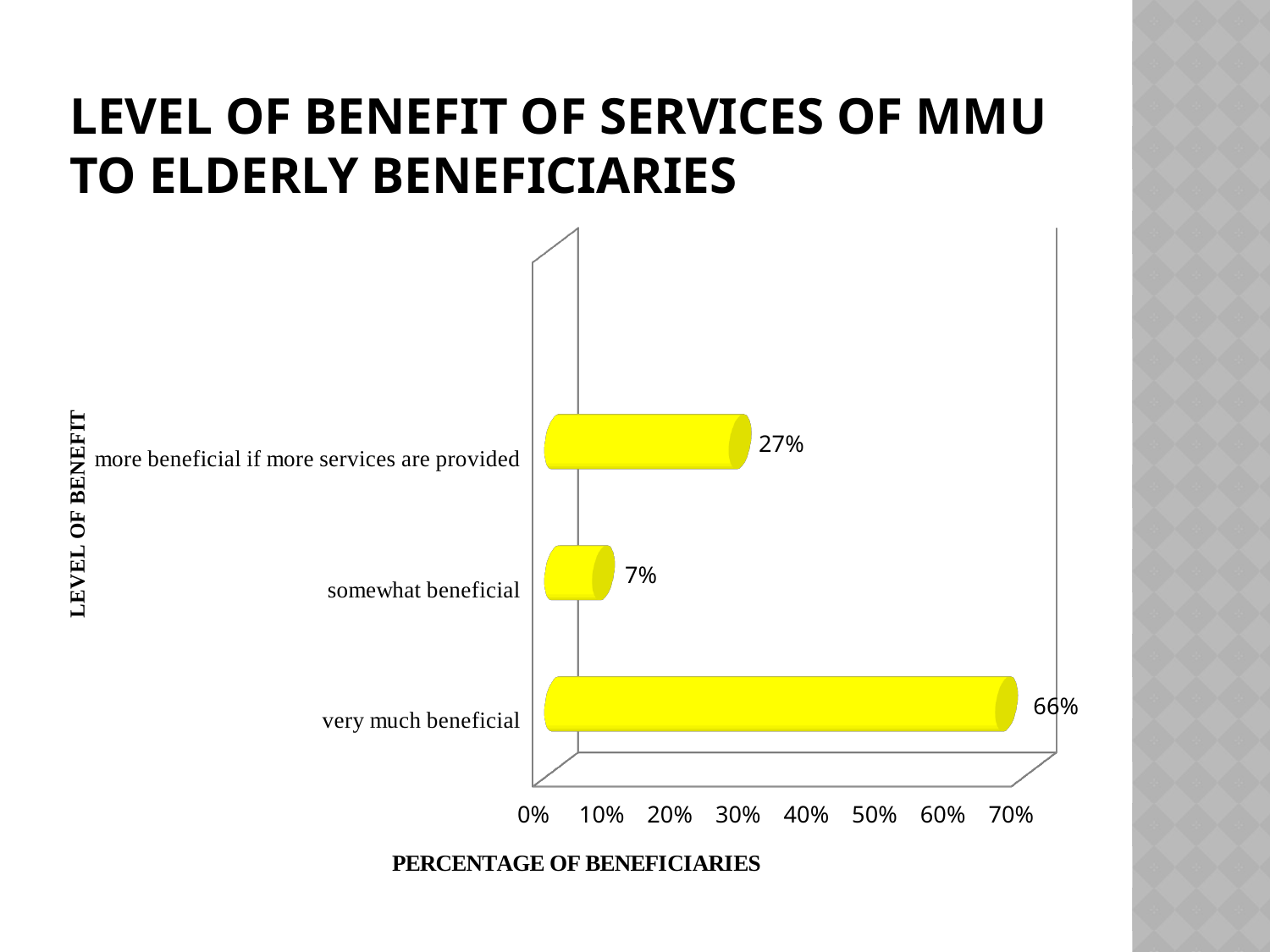
How many levels of benefit are shown in the chart? 3 What is the difference in percentage points between 'more beneficial if more services are provided' and 'somewhat beneficial'? 20 What percentage of beneficiaries said the services would be more beneficial if more services are provided? 27% Is the value for 'very much beneficial' greater or less than 60%? greater What percentage of beneficiaries found the services somewhat beneficial? 7% Which level of benefit has the highest percentage of beneficiaries? very much beneficial What is the label of the horizontal axis of the chart? PERCENTAGE OF BENEFICIARIES What kind of chart is shown on the slide? bar chart Which level of benefit has the lowest percentage of beneficiaries? somewhat beneficial Which has a larger percentage: 'more beneficial if more services are provided' or 'somewhat beneficial'? more beneficial if more services are provided What is the difference in percentage points between 'very much beneficial' and 'somewhat beneficial'? 59 What percentage of beneficiaries found the MMU services very much beneficial? 66%